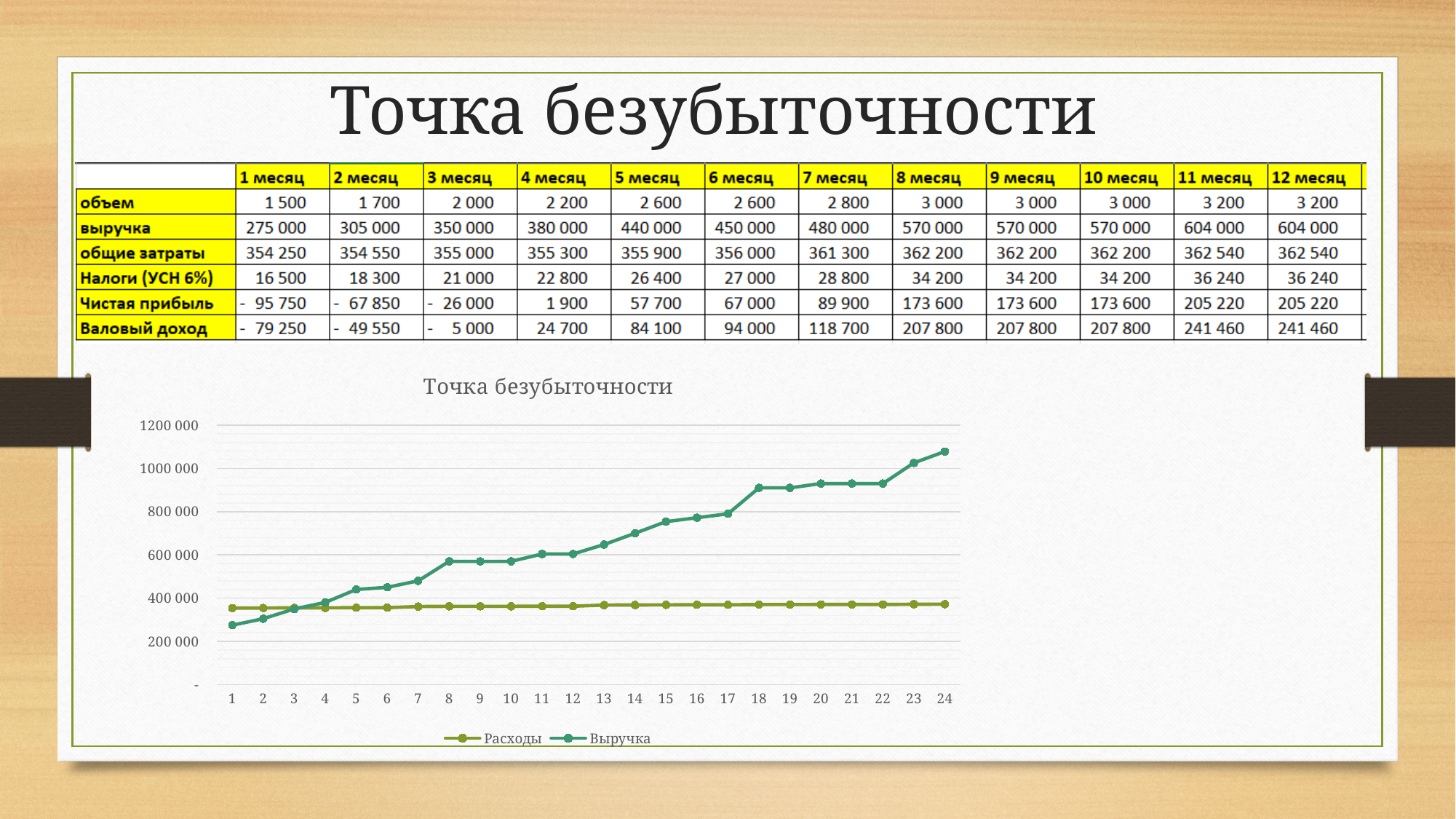
What is the title of the chart? Точка безубыточности At point 24, which series has the higher value, Расходы or Выручка? Выручка Is the value of Выручка at point 18 greater or less than 800 000? greater Is the value of Расходы at point 24 greater or less than 400 000? less How many series does the chart legend list? 2 What kind of chart is shown on the slide? line chart Is the value of Выручка at point 24 greater or less than 1000 000? greater Which two series are listed in the chart legend? Расходы and Выручка How many points are plotted along the x axis of the chart? 24 Does the Выручка series generally rise or fall from point 1 to point 24? rise At point 1, which series has the higher value, Расходы or Выручка? Расходы